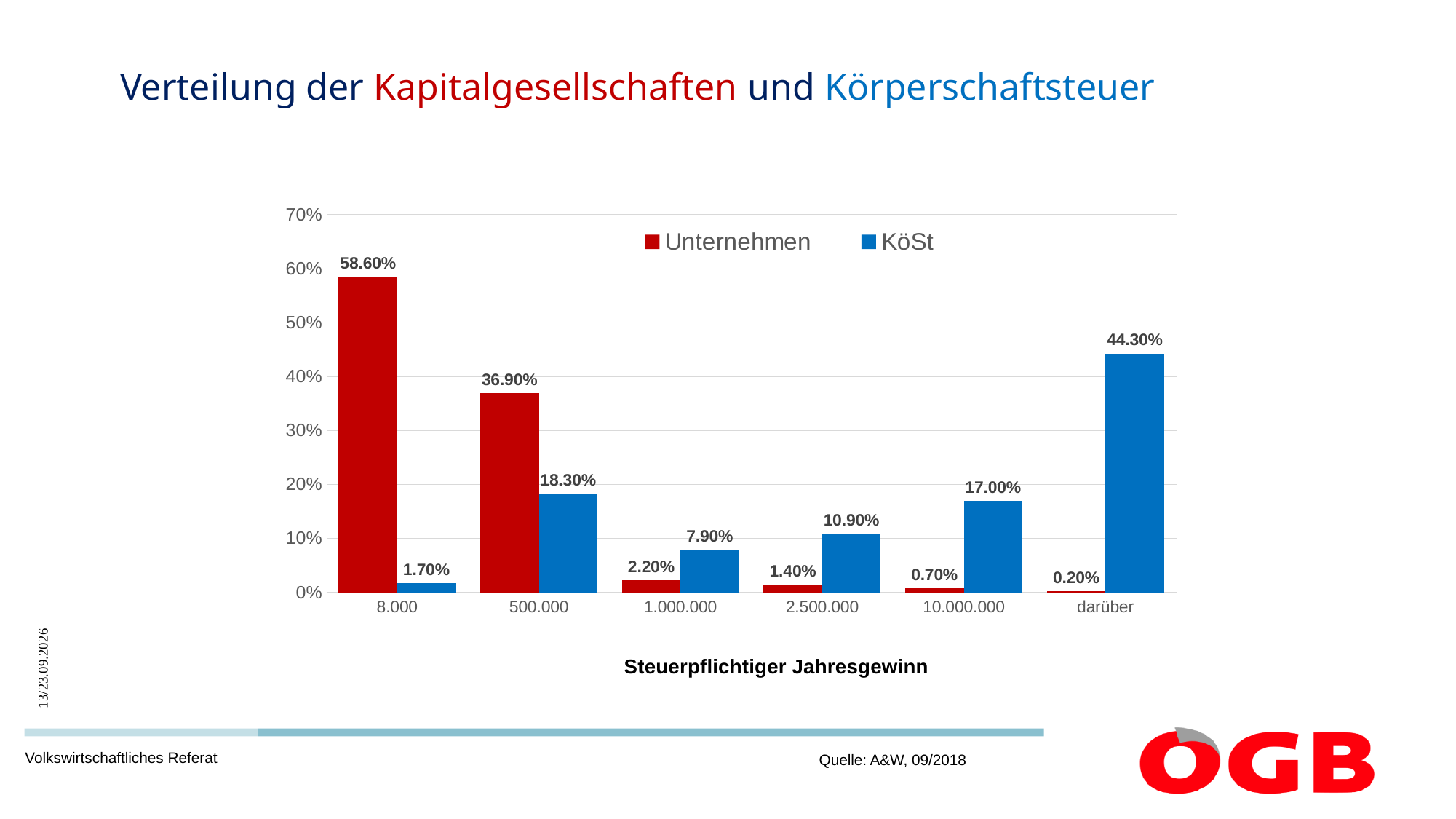
Which category has the highest KöSt value? darüber What is the Unternehmen value for the 8.000 category? 58.60% What is the KöSt value for the darüber category? 44.30% How many categories are shown on the x axis? 6 What is the difference between the Unternehmen and KöSt values for the 500.000 category? 18.60% What is the x axis title of the chart? Steuerpflichtiger Jahresgewinn Which is larger for the 1.000.000 category, Unternehmen or KöSt? KöSt What is the KöSt value for the 2.500.000 category? 10.90% Which category has the lowest Unternehmen value? darüber How many series does the legend list? 2 What kind of chart is shown on the slide? bar chart Do the Unternehmen values rise or fall from left to right along the x axis? fall